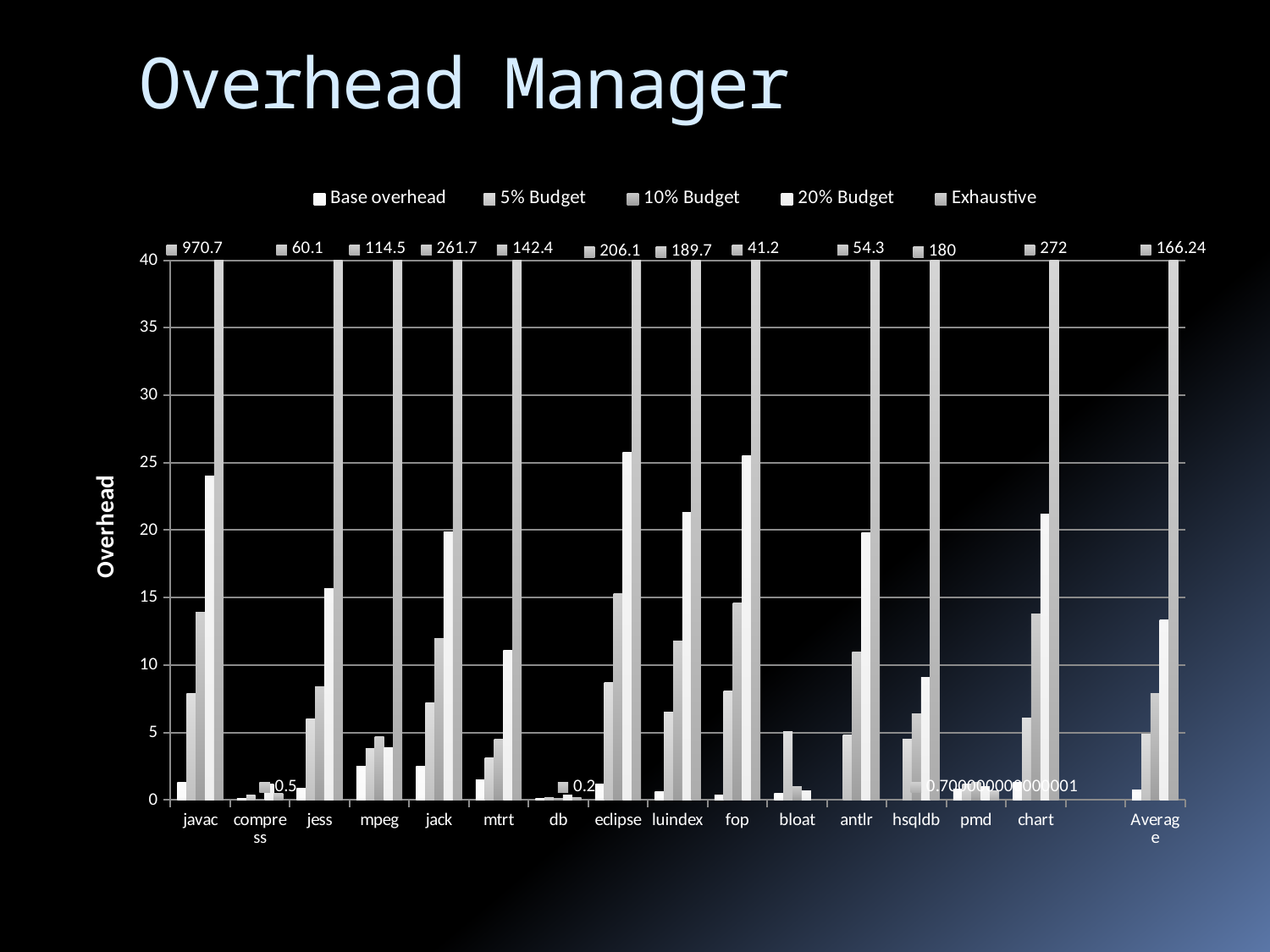
How many benchmark categories are shown along the x axis? 16 What is the title of the y axis? Overhead Is the 20% Budget value for Average greater or less than 10? greater What is the Exhaustive overhead value labeled for chart? 272 What is the Exhaustive overhead value labeled for Average? 166.24 Is the 20% Budget value for javac greater or less than 20? greater Which benchmark has the highest labeled Exhaustive overhead? javac Which has a larger labeled Exhaustive value, fop or antlr? antlr How many series does the legend list? 5 What is the Exhaustive overhead value labeled for javac? 970.7 What is the difference between the labeled Exhaustive values for chart (272) and hsqldb (180)? 92 What type of chart is shown on the slide? bar chart